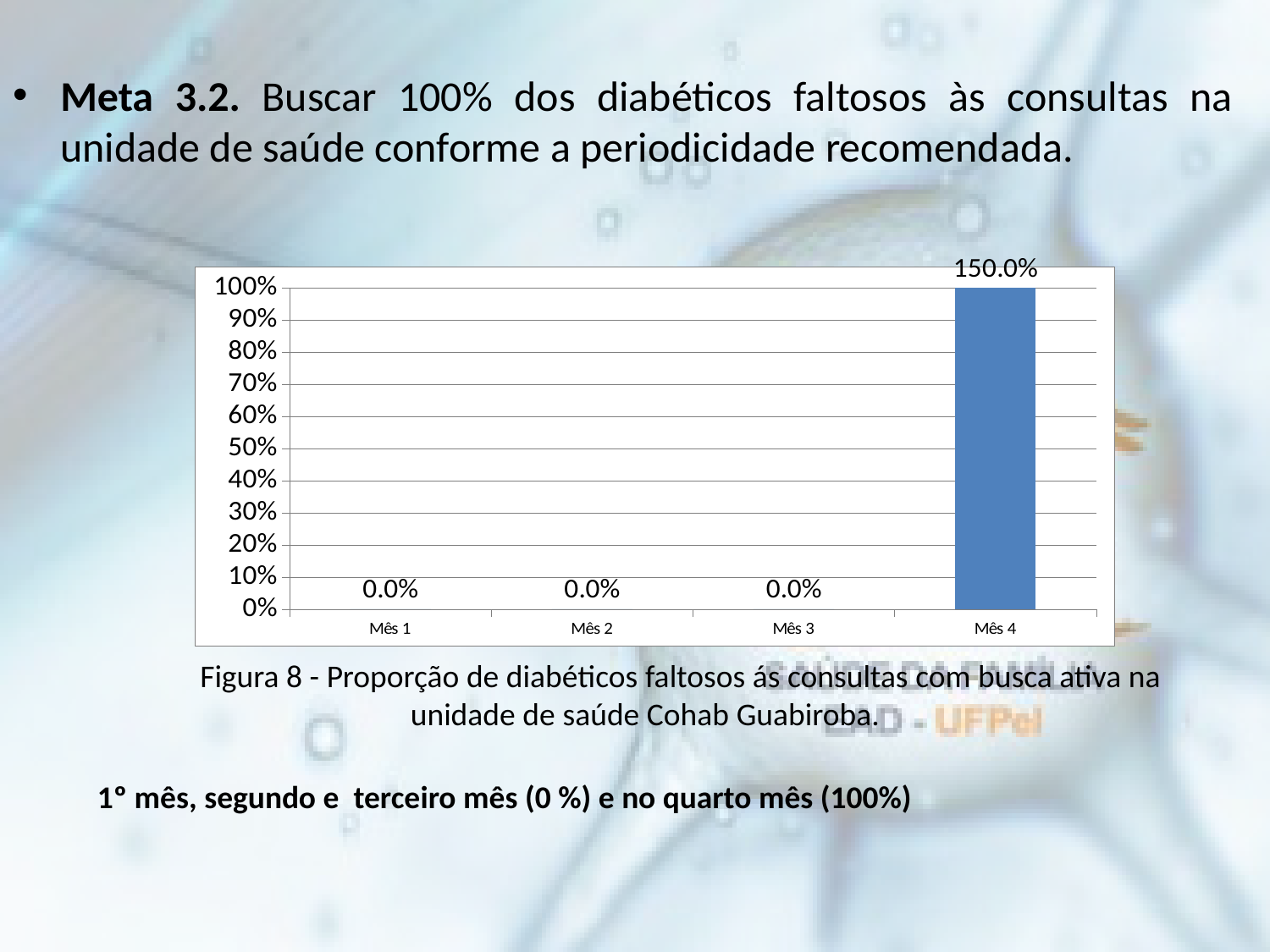
What colour is the bar for Mês 4? Blue How many months (categories) are shown on the x axis? 4 Is the value for Mês 4 greater or less than 50%? greater Which month has the highest value? Mês 4 Which is larger, the value for Mês 2 or the value for Mês 4? Mês 4 What is the value shown for Mês 3? 0.0% What is the value shown for Mês 1? 0.0% What is the data label shown for Mês 4? 150.0% What kind of chart is this? Bar chart Do the values rise or fall from Mês 3 to Mês 4? Rise What is the highest tick value shown on the y axis? 100% What is the difference between the data labels for Mês 4 and Mês 3? 150.0%